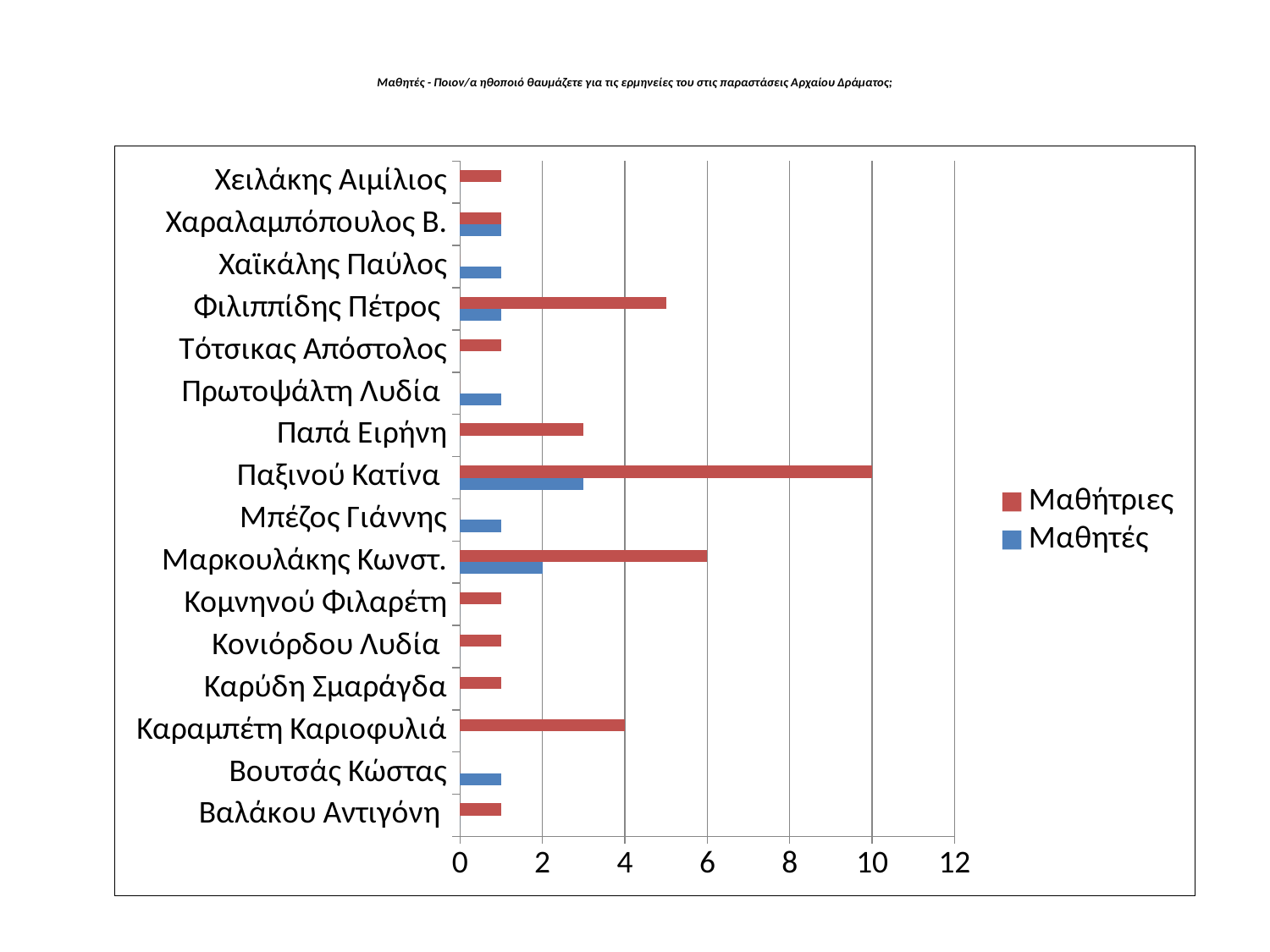
What is the Μαθήτριες value for Παξινού Κατίνα? 10 How many series does the legend list? 2 Which actor has the highest value for Μαθήτριες? Παξινού Κατίνα What is the difference between the Μαθήτριες values for Παξινού Κατίνα and Μαρκουλάκης Κωνστ.? 4 What is the Μαθήτριες value for Μαρκουλάκης Κωνστ.? 6 How many actors (categories) are listed on the chart? 16 Which is larger: the Μαθήτριες value for Μαρκουλάκης Κωνστ. or for Καραμπέτη Καριοφυλιά? Μαρκουλάκης Κωνστ. Which series is shown in red in the legend? Μαθήτριες What is the Μαθήτριες value for Καραμπέτη Καριοφυλιά? 4 What kind of chart is shown on the slide? bar chart Is the Μαθήτριες value for Φιλιππίδης Πέτρος greater or less than 4? greater What is the Μαθητές value for Μαρκουλάκης Κωνστ.? 2